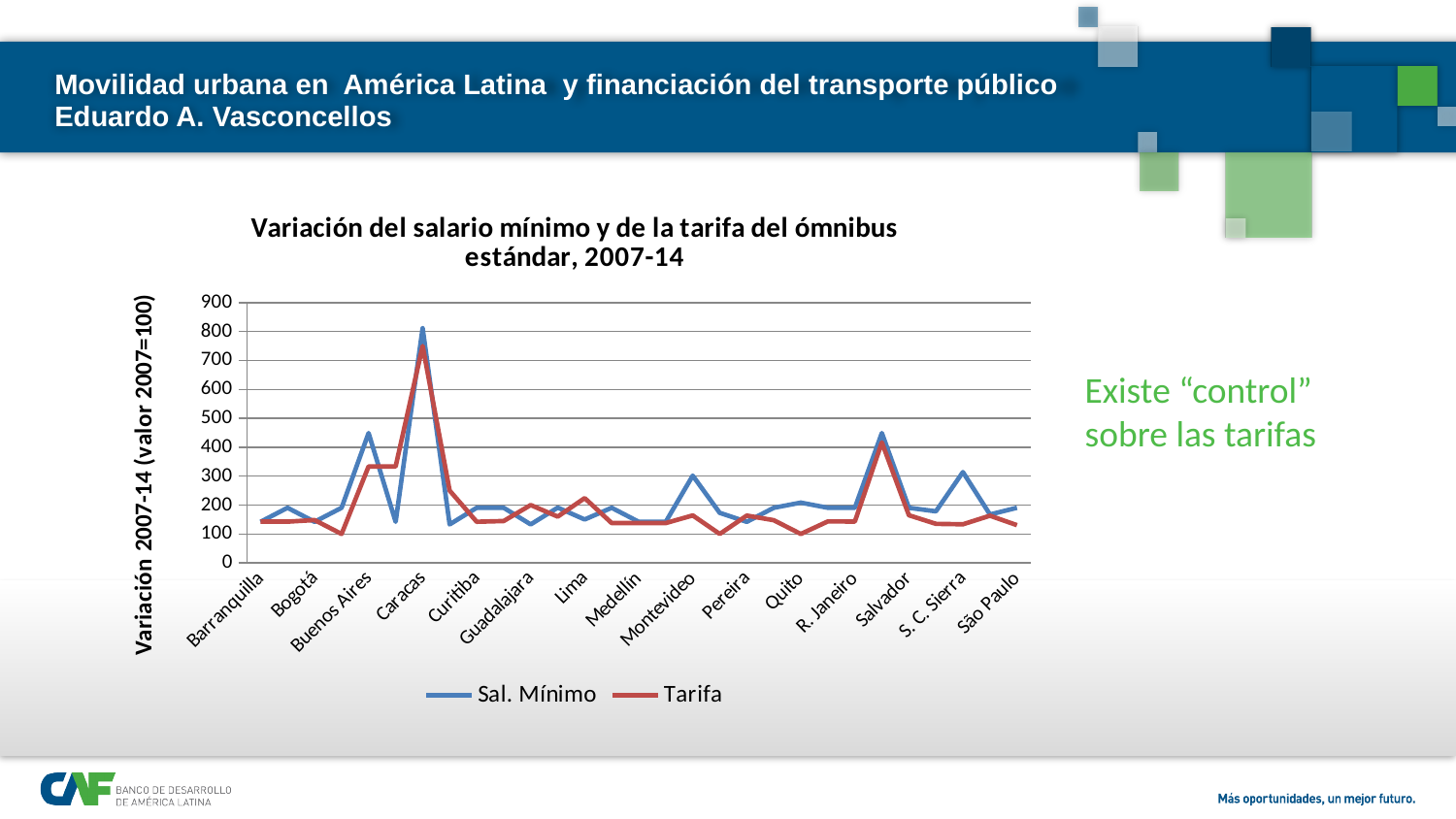
Which city has the highest value for Sal. Mínimo? Caracas At S. C. Sierra, which series has the larger value, Sal. Mínimo or Tarifa? Sal. Mínimo Is the Sal. Mínimo value for Montevideo greater or less than 200? greater At Caracas, which series has the larger value, Sal. Mínimo or Tarifa? Sal. Mínimo What is the title of the vertical axis? Variación 2007-14 (valor 2007=100) Is the Sal. Mínimo value for Buenos Aires greater or less than 400? greater Is the Tarifa value for S. C. Sierra greater or less than 200? less How many series does the legend list? 2 What kind of chart is shown on the slide? Line chart Which city has the highest value for Tarifa? Caracas